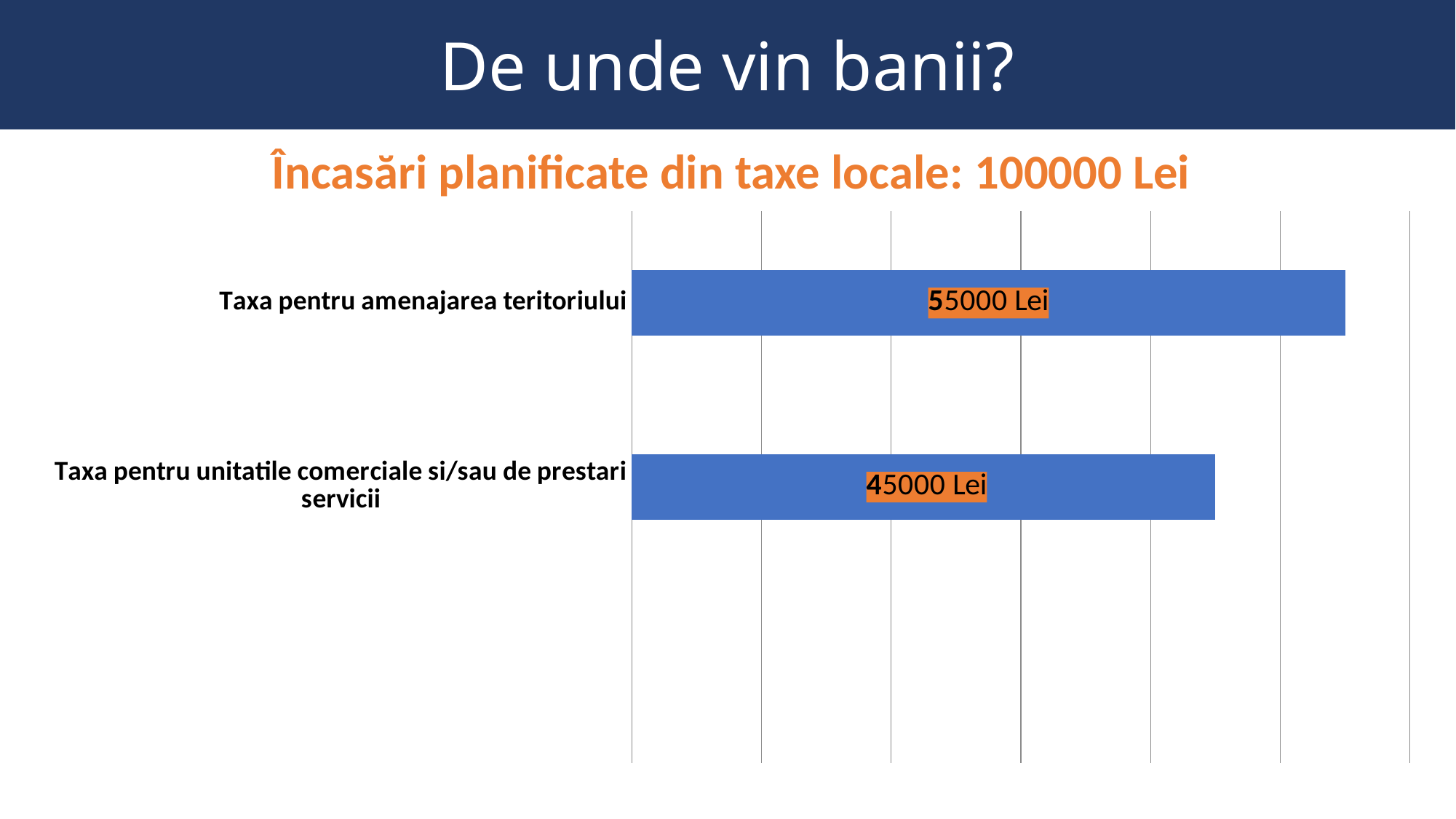
What is the difference between the value for Taxa pentru amenajarea teritoriului and the value for Taxa pentru unitatile comerciale si/sau de prestari servicii? 10000 Lei What is the total of the two values shown in the chart? 100000 Lei What kind of chart is shown on the slide? Bar chart Which is larger: the value for Taxa pentru amenajarea teritoriului or the value for Taxa pentru unitatile comerciale si/sau de prestari servicii? Taxa pentru amenajarea teritoriului Which category has the highest value? Taxa pentru amenajarea teritoriului What is the value for Taxa pentru unitatile comerciale si/sau de prestari servicii? 45000 Lei What colour are the bars in the chart? Blue What is the value for Taxa pentru amenajarea teritoriului? 55000 Lei How many categories are shown in the chart? 2 What is the title shown above the chart? Încasări planificate din taxe locale: 100000 Lei Which category has the lowest value? Taxa pentru unitatile comerciale si/sau de prestari servicii